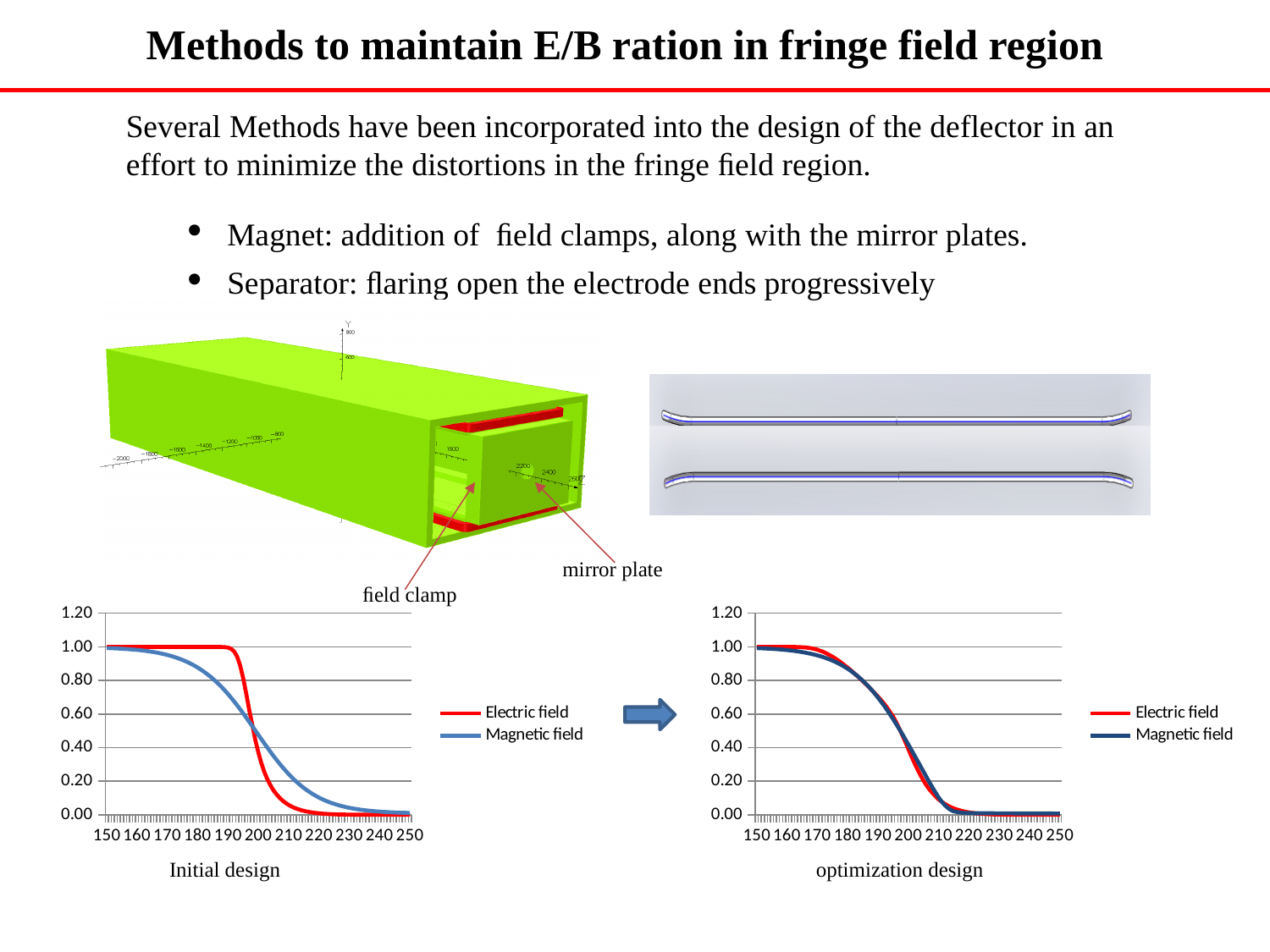
How many series does the legend of the 'optimization design' chart list? 2 In the 'Initial design' chart, what colour is the Electric field line? red In the 'optimization design' chart, do the values of the Magnetic field series rise or fall along the x axis? fall What kind of chart is the 'Initial design' chart? line chart In the 'optimization design' chart, is the Electric field value at 230 greater or less than 0.20? less In the 'optimization design' chart, is the Magnetic field value at 160 greater or less than 0.80? greater In the 'Initial design' chart, is the Electric field value at 190 greater or less than 0.80? greater In the 'Initial design' chart, which series has the larger value at 220, Electric field or Magnetic field? Magnetic field In the 'Initial design' chart, do the values of the Electric field series rise or fall as the x axis goes from 150 to 250? fall In the 'Initial design' chart, which series has the larger value at 190, Electric field or Magnetic field? Electric field